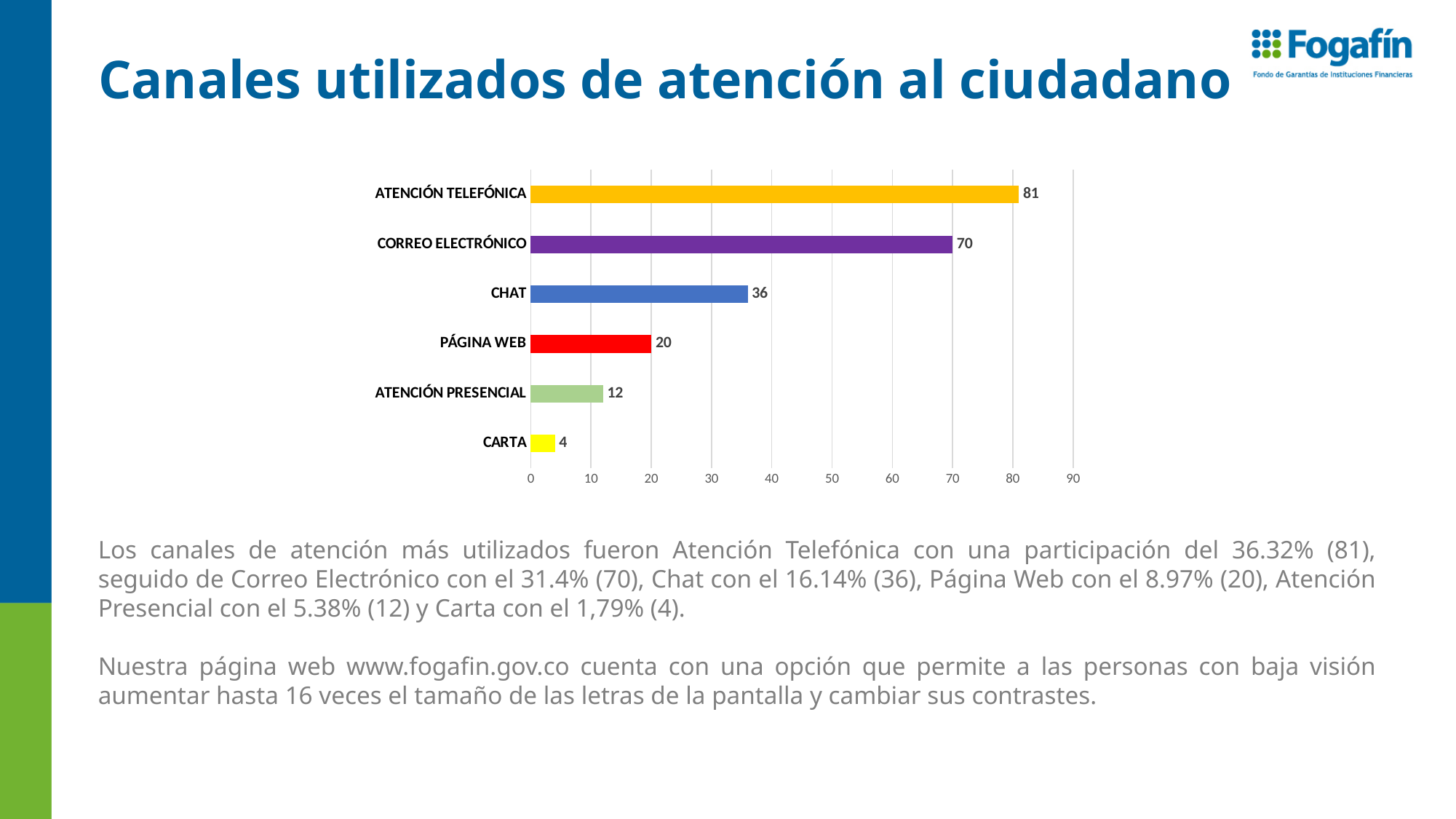
Which category has the highest value? ATENCIÓN TELEFÓNICA What is the value for CORREO ELECTRÓNICO? 70 What is the value for ATENCIÓN TELEFÓNICA? 81 How many categories are shown in the chart? 6 What is the value for CHAT? 36 What is the difference between the values for CHAT and PÁGINA WEB? 16 What is the difference between the values for ATENCIÓN TELEFÓNICA and CORREO ELECTRÓNICO? 11 What is the value for ATENCIÓN PRESENCIAL? 12 What kind of chart is shown on the slide? Bar chart Which category has the lowest value? CARTA What colour is the bar for CORREO ELECTRÓNICO? Purple Which is larger, the value for PÁGINA WEB or the value for ATENCIÓN PRESENCIAL? PÁGINA WEB